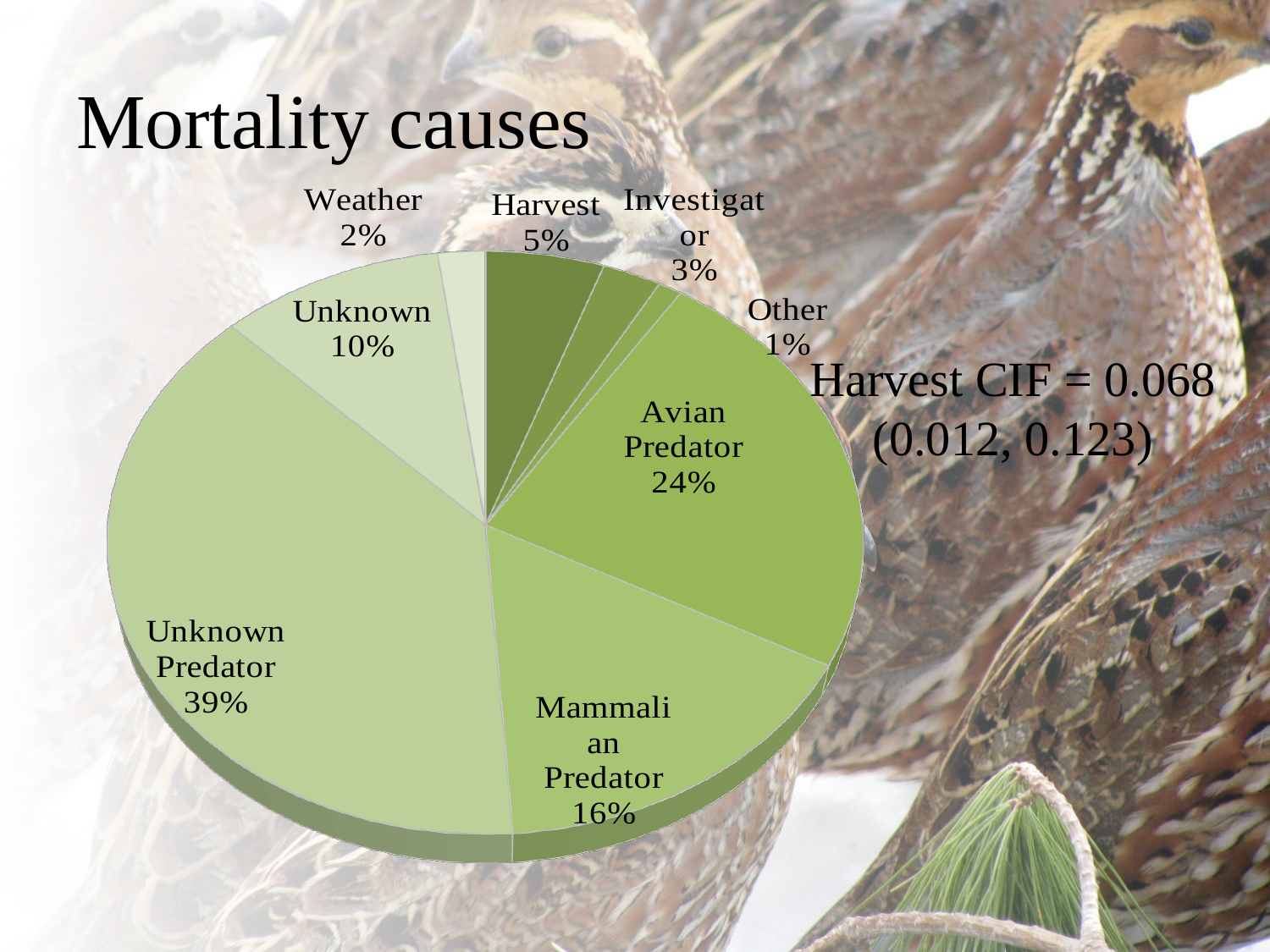
What percentage is labelled for Harvest? 5% Which mortality cause has the largest slice of the pie? Unknown Predator What is the difference in percentage points between Unknown Predator and Avian Predator? 15 What type of chart is shown on the slide? Pie chart Which is larger, the Unknown slice or the Harvest slice? Unknown What percentage of the pie is Avian Predator? 24% What is the title of the slide containing the chart? Mortality causes How many slices does the pie chart have? 8 What share is attributed to Weather? 2% What share does Mammalian Predator account for? 16% Which mortality cause has the smallest slice of the pie? Other What share of mortality causes is attributed to Unknown Predator? 39%